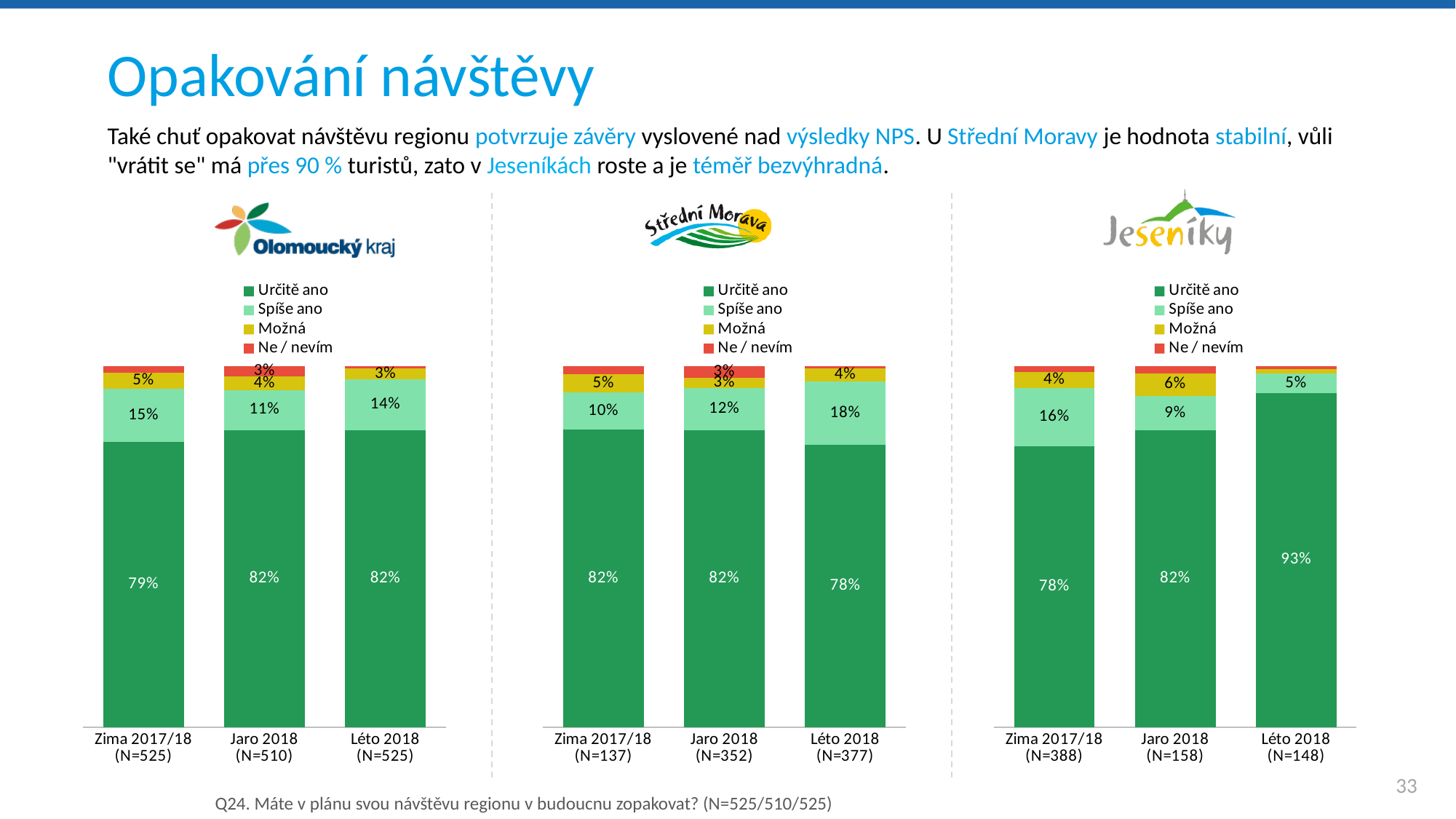
In the Jeseníky chart, which period has the highest 'Určitě ano' value? Léto 2018 (N=148) How many series does the legend of the Olomoucký kraj chart list? 4 In the Jeseníky chart, what is the difference between the 'Určitě ano' values for Léto 2018 and Zima 2017/18? 15% In the Jeseníky chart, does the 'Určitě ano' value rise or fall from Zima 2017/18 to Léto 2018? Rise In the Střední Morava chart, which period has the lowest 'Určitě ano' value? Léto 2018 (N=377) In the Jeseníky chart, what is the 'Určitě ano' value for Léto 2018 (N=148)? 93% In the Olomoucký kraj chart, what is the 'Spíše ano' value for Zima 2017/18 (N=525)? 15% How many periods (bars) are shown in the Střední Morava chart? 3 What type of chart is used for the Jeseníky data? Stacked bar chart In the Střední Morava chart, what is the 'Spíše ano' value for Léto 2018 (N=377)? 18% In the Jeseníky chart, what is the 'Možná' value for Jaro 2018 (N=158)? 6% In the Olomoucký kraj chart, is the 'Spíše ano' value larger for Zima 2017/18 or for Jaro 2018? Zima 2017/18